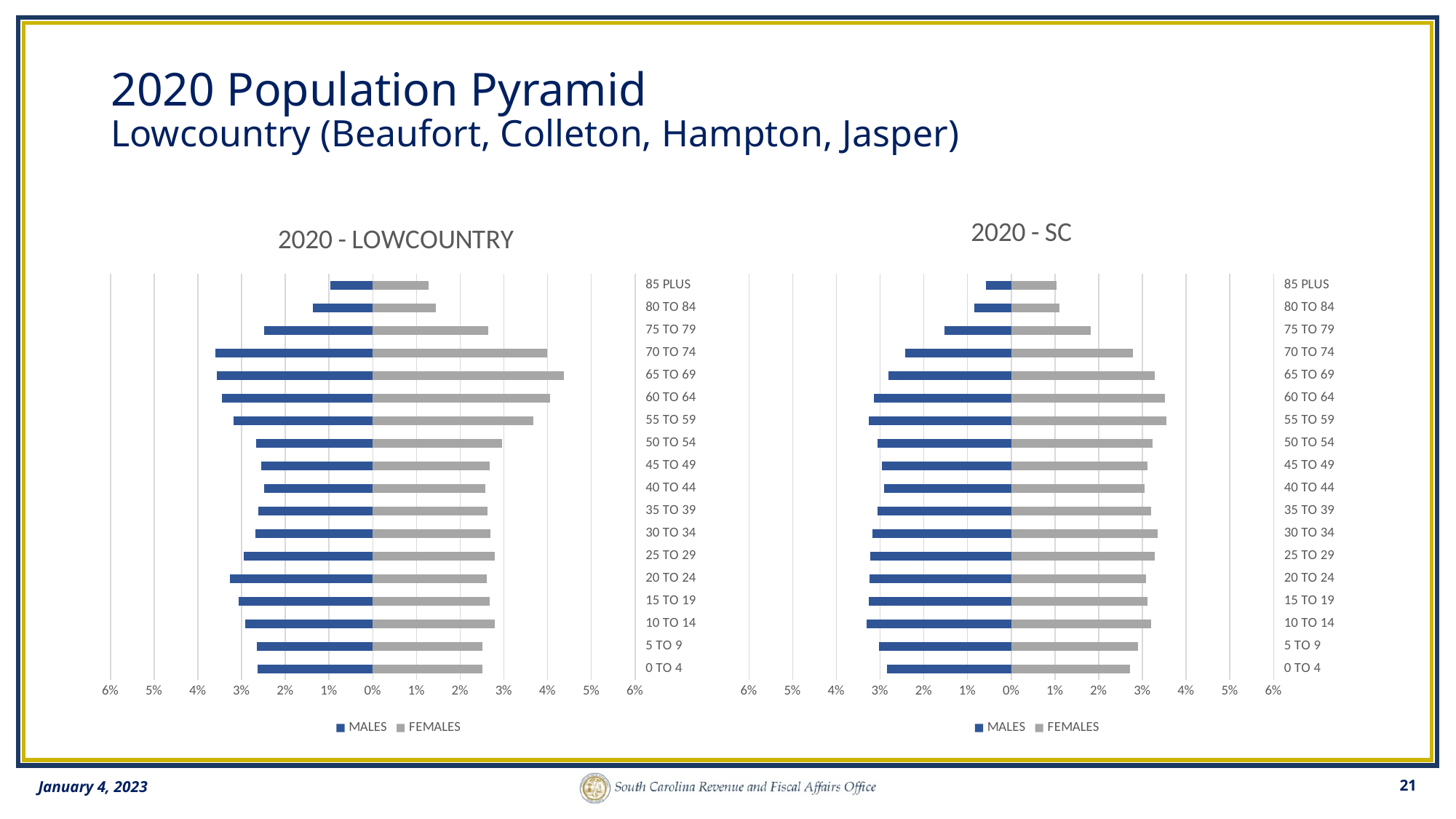
In the 2020 - LOWCOUNTRY chart, is the FEMALES value for 65 TO 69 greater or less than 4%? greater In the 2020 - LOWCOUNTRY chart, which age group has the shortest MALES bar? 85 PLUS In the 2020 - SC chart, is the MALES value for 0 TO 4 greater or less than 3%? less What are the two legend entries of the 2020 - LOWCOUNTRY chart? MALES and FEMALES How many age groups are shown on the 2020 - LOWCOUNTRY chart? 18 In the 2020 - LOWCOUNTRY chart, which age group has the longest FEMALES bar? 65 TO 69 How many series does the legend of the 2020 - SC chart list? 2 What kind of chart is the 2020 - LOWCOUNTRY chart? bar chart In the 2020 - SC chart, is the MALES value for 75 TO 79 greater or less than 1%? greater In the 2020 - SC chart, for the 70 TO 74 age group, which is larger, the MALES value or the FEMALES value? FEMALES In the 2020 - SC chart, which age group has the shortest FEMALES bar? 85 PLUS